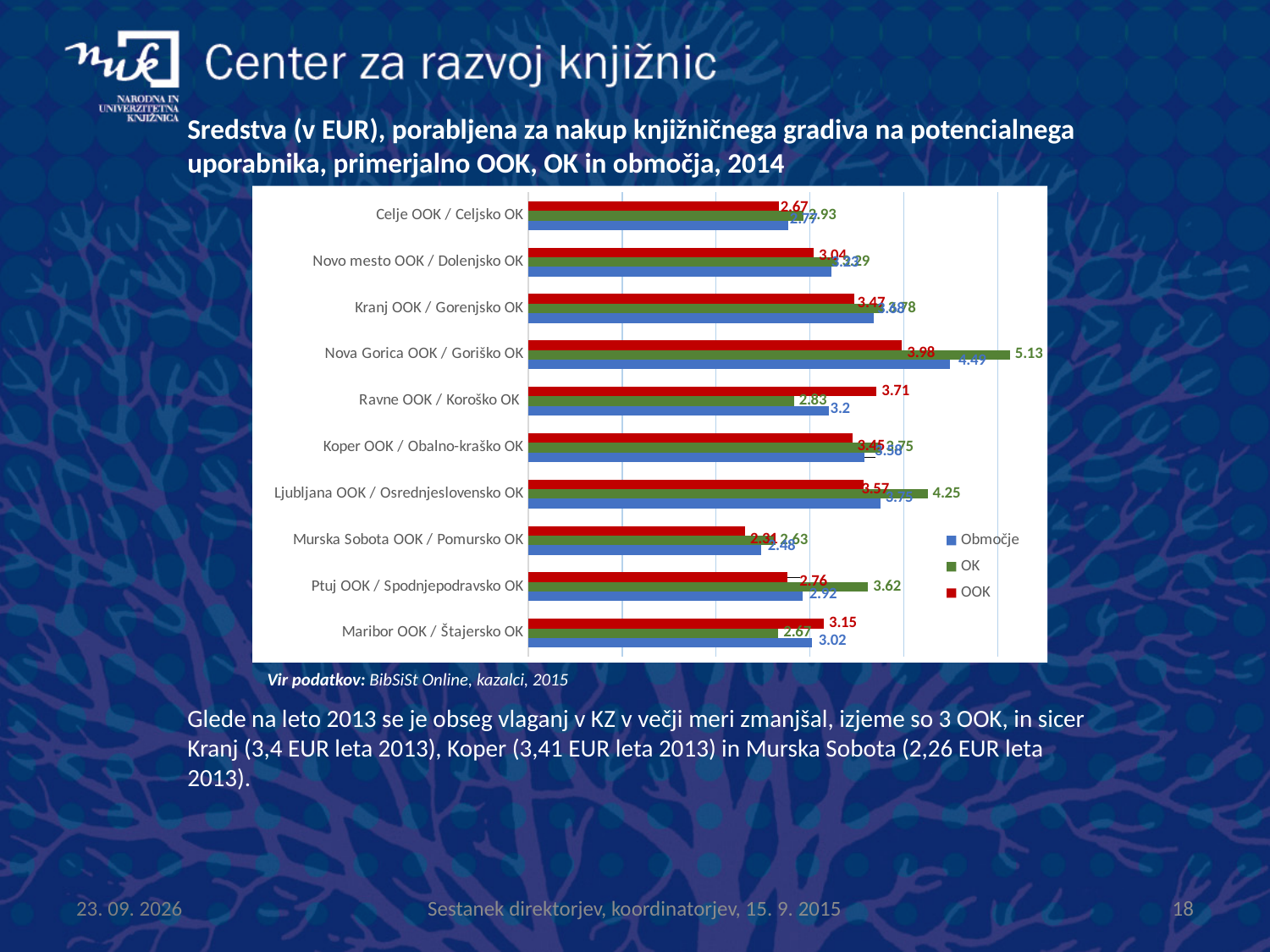
What is the Območje value for Ravne OOK / Koroško OK? 3.2 What are the three entries listed in the legend? Območje, OK, OOK Which category has the lowest OOK value? Murska Sobota OOK / Pomursko OK How many series does the legend list? 3 What is the OK value for Nova Gorica OOK / Goriško OK? 5.13 What kind of chart is shown on the slide? bar chart What is the OOK value for Ravne OOK / Koroško OK? 3.71 How many categories (library pairs) are shown on the chart? 10 What is the difference between the OK value and the OOK value for Ptuj OOK / Spodnjepodravsko OK? 0.86 For Maribor OOK / Štajersko OK, which is larger: the OOK value or the OK value? OOK Which category has the highest OK value? Nova Gorica OOK / Goriško OK What is the OOK value for Murska Sobota OOK / Pomursko OK? 2.31